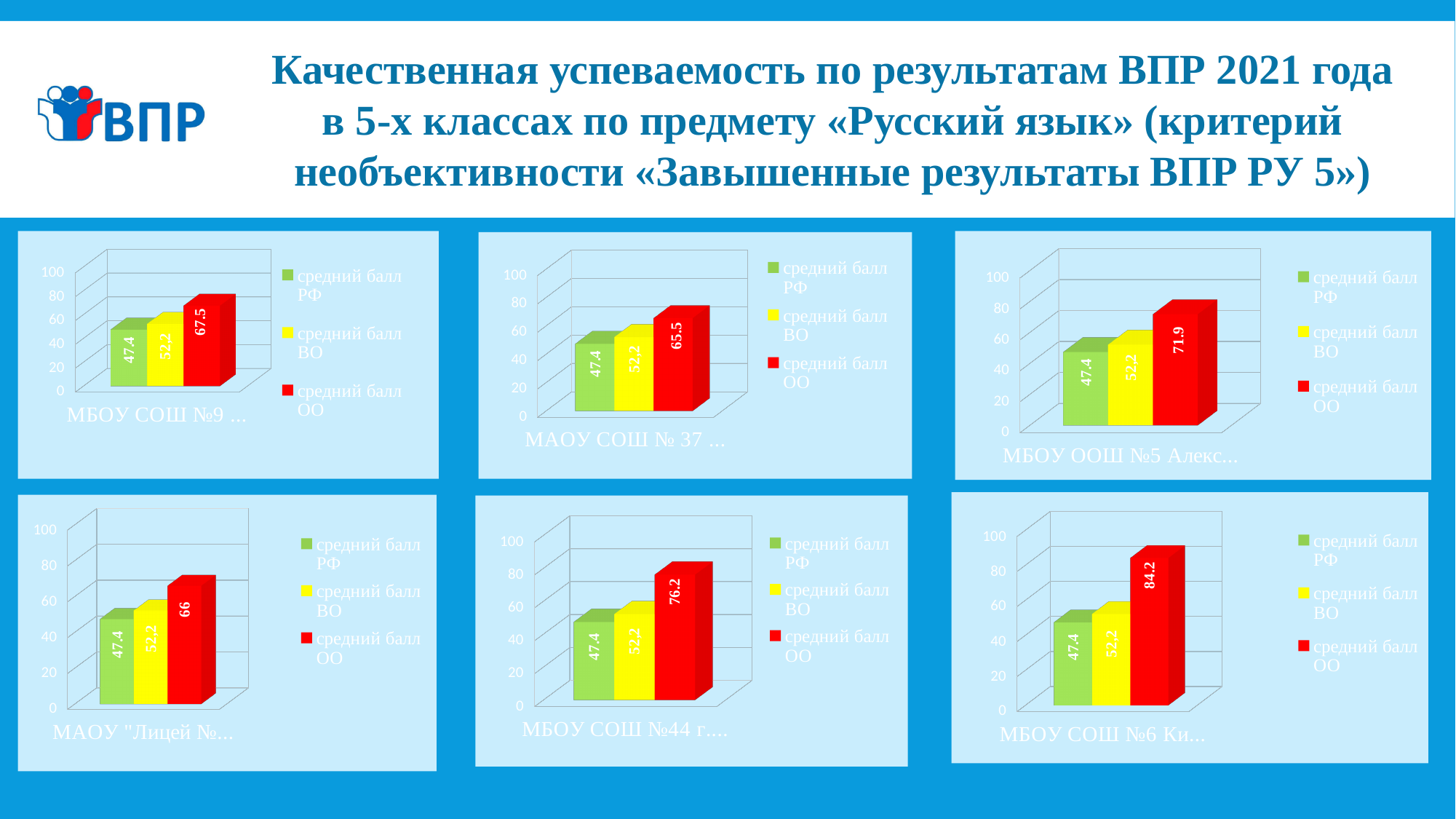
In the top-middle chart, which series has the highest value? средний балл ОО In the bottom-left chart (МАОУ "Лицей), what is the value for средний балл ОО? 66 In the bottom-left chart, which series has the lowest value? средний балл РФ In the top-left chart (МБОУ СОШ №9), what is the value for средний балл ОО? 67.5 In the top-middle chart (МАОУ СОШ № 37), what is the value for средний балл ОО? 65.5 In the top-right chart (МБОУ ООШ №5), what is the value for средний балл ОО? 71.9 In the bottom-middle chart (МБОУ СОШ №44), what is the value for средний балл ОО? 76.2 How many series does the legend of the bottom-middle chart list? 3 In the bottom-right chart, what is the difference between средний балл ОО and средний балл ВО? 32 What kind of chart is the top-right chart? bar chart In the bottom-right chart (МБОУ СОШ №6), what is the value for средний балл ОО? 84.2 In the top-left chart, what is the value for средний балл РФ? 47.4